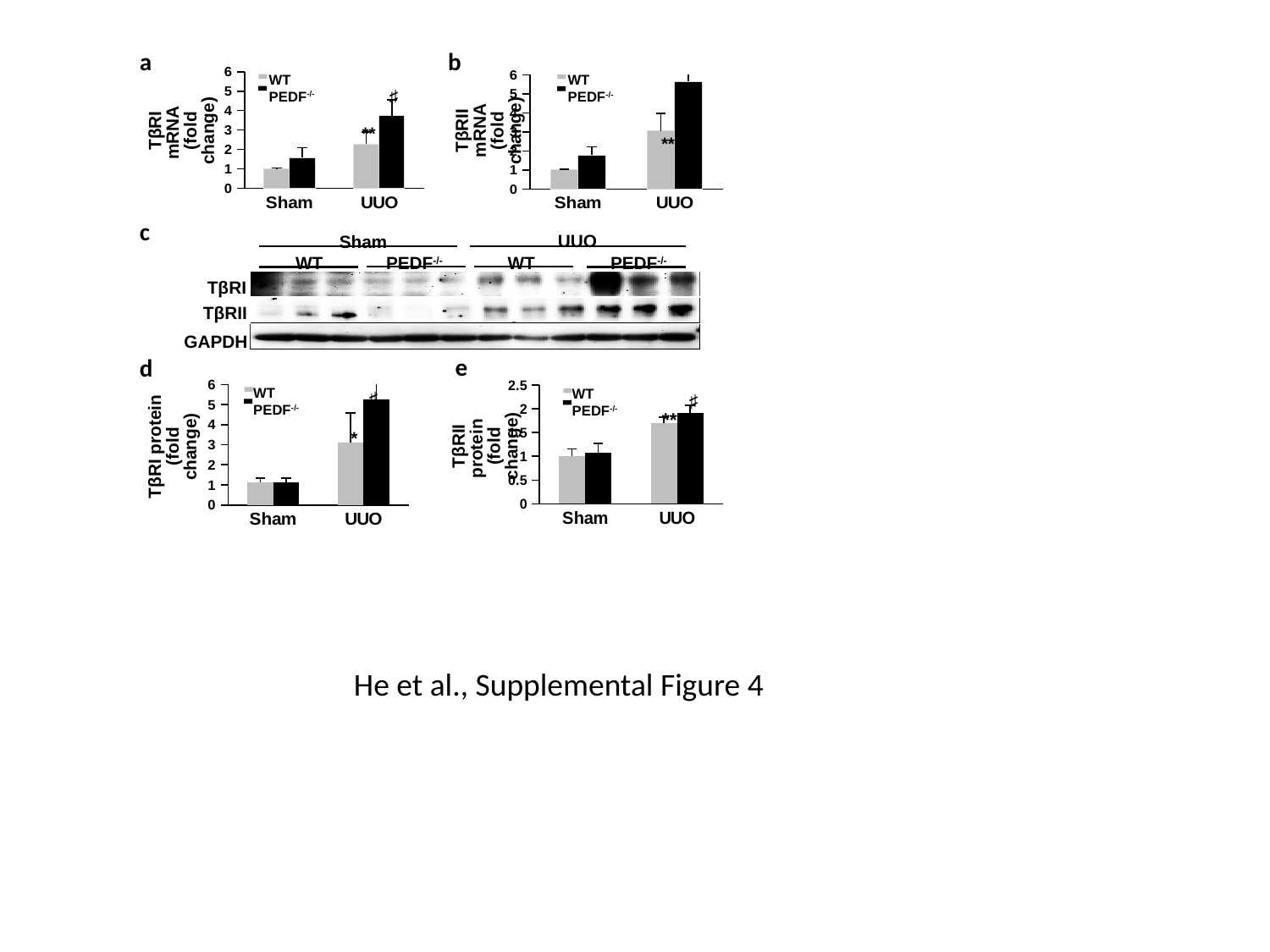
In chart d (TβRI protein), which is larger under UUO, WT or PEDF-/-? PEDF-/- In chart d (TβRI protein), what colour represents the WT series in the legend? grey In chart a (TβRI mRNA), how many categories are shown on the x axis? 2 What kind of chart is chart a (TβRI mRNA)? bar chart In chart d (TβRI protein), is the value for PEDF-/- under UUO greater or less than 4? greater In chart a (TβRI mRNA), how many series does the legend list? 2 In chart b (TβRII mRNA), is the value for PEDF-/- under UUO greater or less than 5? greater In chart e (TβRII protein), what is the maximum value shown on the y axis? 2.5 In chart e (TβRII protein), is the value for WT under UUO greater or less than 1? greater In chart b (TβRII mRNA), which group has the lowest value? WT Sham In chart a (TβRI mRNA), which group has the highest value? PEDF-/- UUO